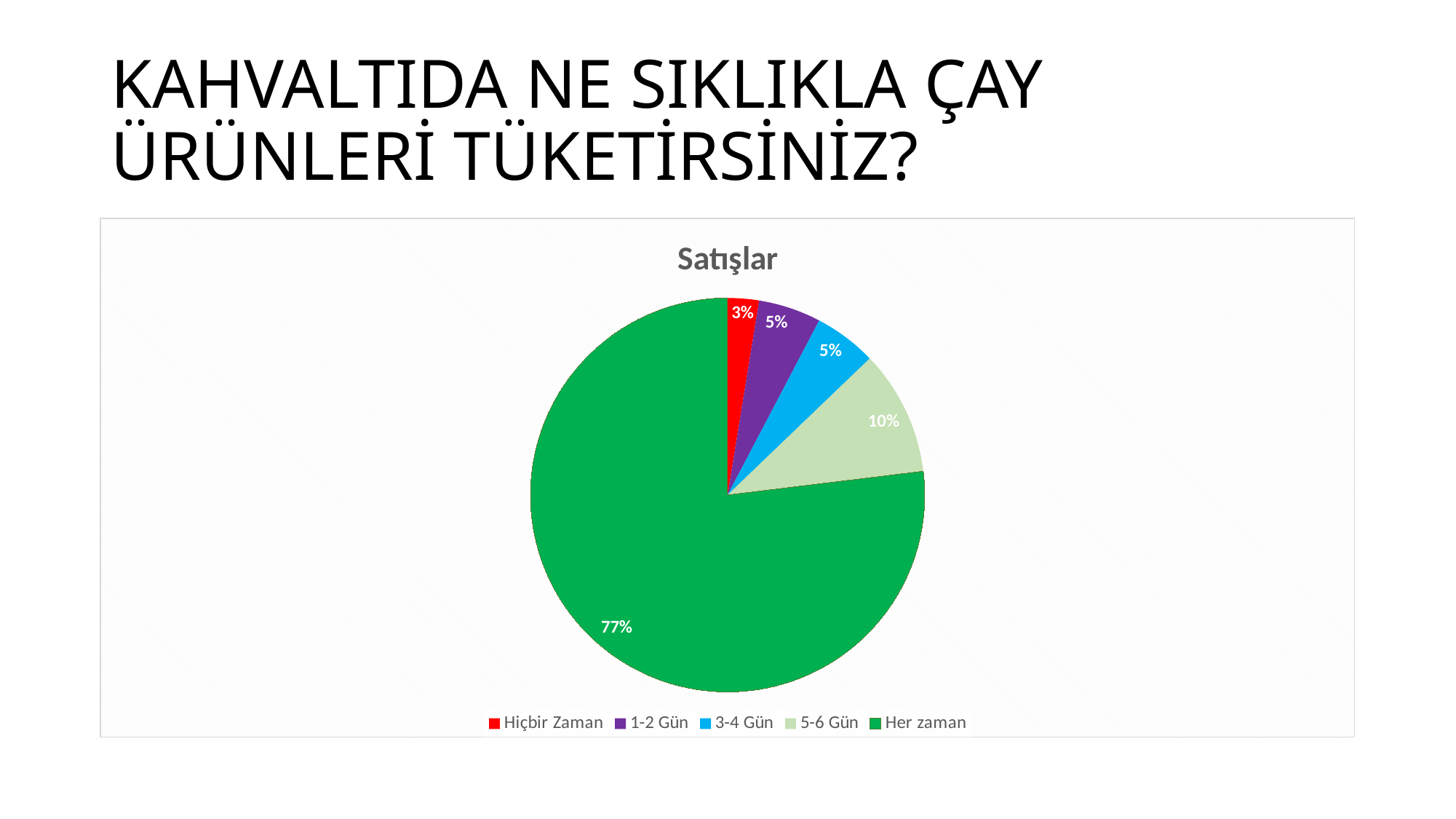
What is the difference between the 'Her zaman' and '5-6 Gün' values? 67% What kind of chart is shown on the slide? pie chart What is the value for 'Hiçbir Zaman'? 3% Which is larger, the value for '5-6 Gün' or the value for '3-4 Gün'? 5-6 Gün What colour is the 'Hiçbir Zaman' slice? red Which category has the largest slice? Her zaman What is the value for '5-6 Gün'? 10% Which category has the smallest slice? Hiçbir Zaman What is the value for '1-2 Gün'? 5% What share of the pie does 'Her zaman' take? 77% How many categories does the legend list? 5 What is the chart's title? Satışlar